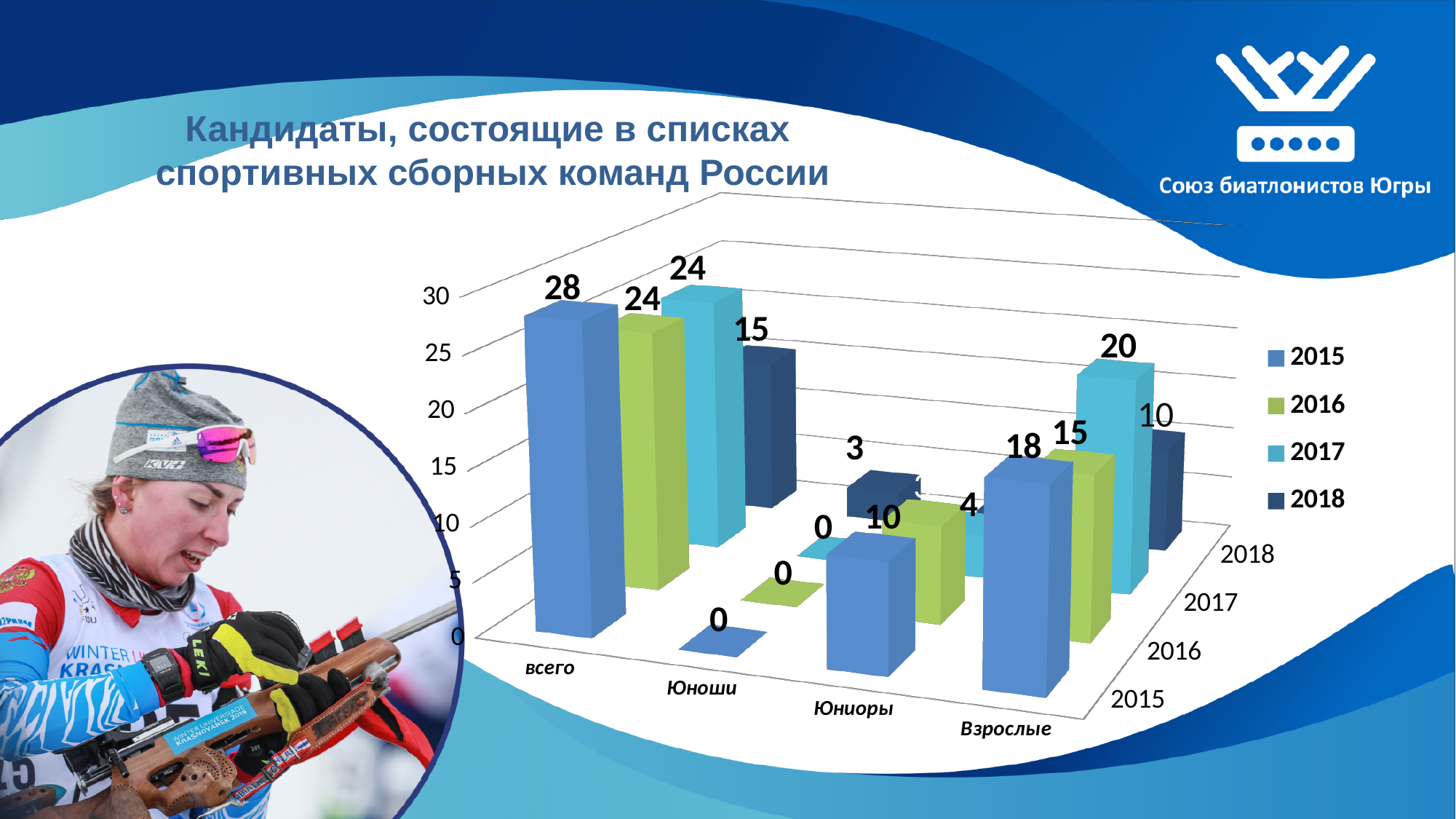
Which year has the lowest value for 'Взрослые'? 2018 What kind of chart is shown on the slide? bar chart What is the value for 'Взрослые' in 2017? 20 What is the value for 'Юноши' in 2015? 0 What is the value for 'всего' in 2015? 28 Which year has the highest value for 'всего'? 2015 What is the value for 'всего' in 2018? 15 What is the difference between the 'всего' values for 2015 and 2018? 13 Which is larger: 'Взрослые' in 2016 or 'Взрослые' in 2017? 2017 How many series does the legend list? 4 How many categories are shown on the category axis? 4 What is the value for 'Взрослые' in 2015? 18